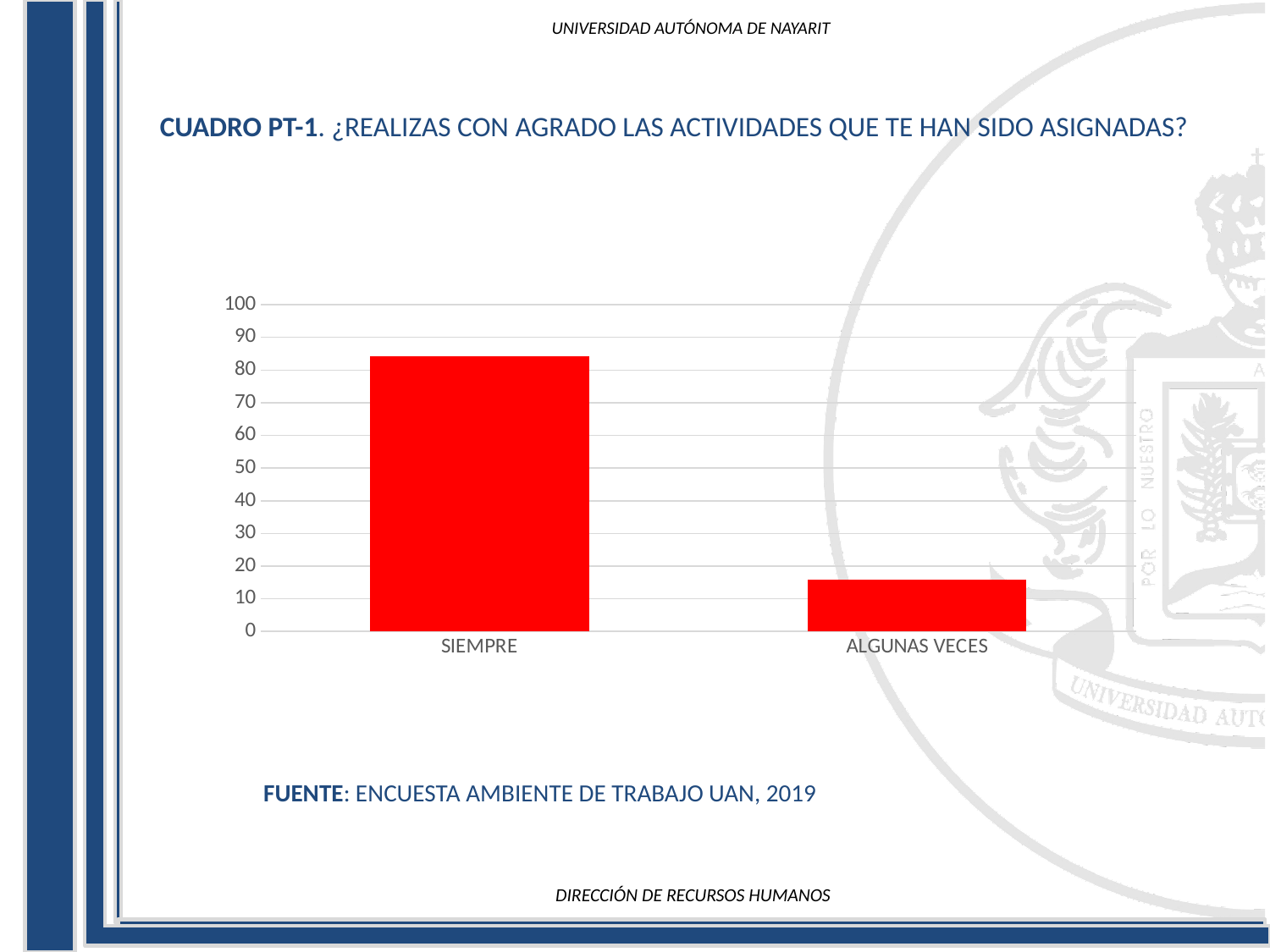
Is the value for ALGUNAS VECES greater or less than 10? greater Is the value for SIEMPRE greater or less than 70? greater Do the bar values rise or fall from left to right along the x axis? fall Is the value for SIEMPRE greater or less than 90? less Which category has the highest bar in the chart? SIEMPRE What is the source cited below the chart? ENCUESTA AMBIENTE DE TRABAJO UAN, 2019 How many categories are plotted on the x axis of the chart? 2 What kind of chart is shown on the slide? bar chart What colour are the bars in the chart? red Which category has the lowest bar in the chart? ALGUNAS VECES Which is larger, the value for SIEMPRE or the value for ALGUNAS VECES? SIEMPRE